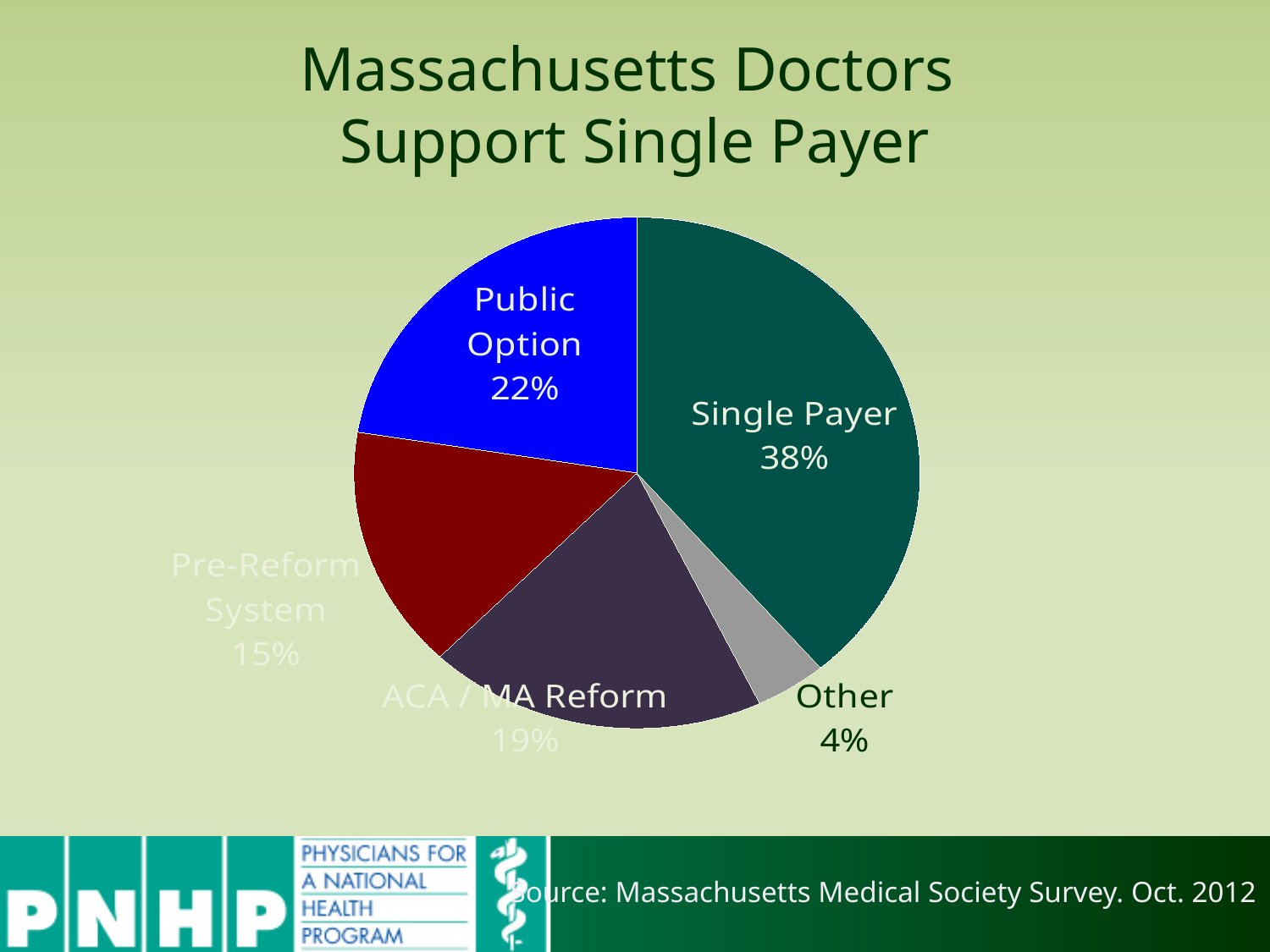
What is the title of the chart on the slide? Massachusetts Doctors Support Single Payer Which is larger, the share for Public Option or the share for ACA / MA Reform? Public Option What percentage is shown for Pre-Reform System? 15% How many slices does the pie chart have? 5 Which option has the largest share of the pie? Single Payer What kind of chart is shown on the slide? Pie chart What percentage is shown for Public Option? 22% What is the difference in percentage points between Single Payer and Public Option? 16 What percentage is shown for ACA / MA Reform? 19% What percentage is shown for Other? 4% What percentage of Massachusetts doctors support Single Payer? 38% Which option has the smallest share of the pie? Other